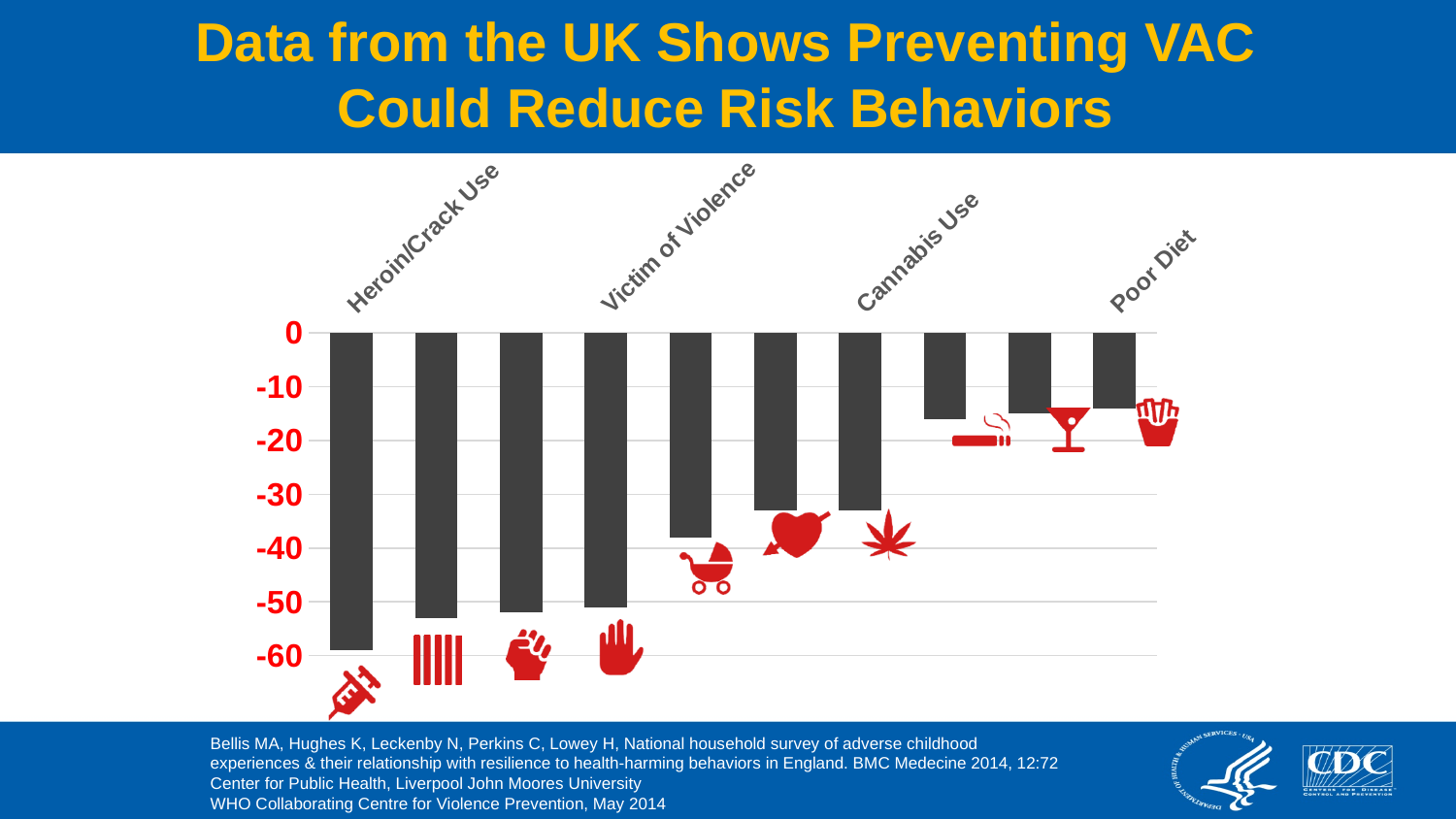
What is the lowest value shown on the vertical axis? -60 Is the value for Cannabis Use greater or less than -40? greater Which category has the longest (most negative) bar in the chart? Heroin/Crack Use Is the value for Poor Diet greater or less than -10? less Is the value for Cannabis Use greater or less than -30? less Which bar is longer, Cannabis Use or Poor Diet? Cannabis Use What kind of chart is shown on the slide? bar chart How many bars are plotted in the chart? 10 Which bar is longer, Heroin/Crack Use or Victim of Violence? Heroin/Crack Use Do the bar values rise or fall (move toward zero or away from it) from left to right across the chart? rise toward zero